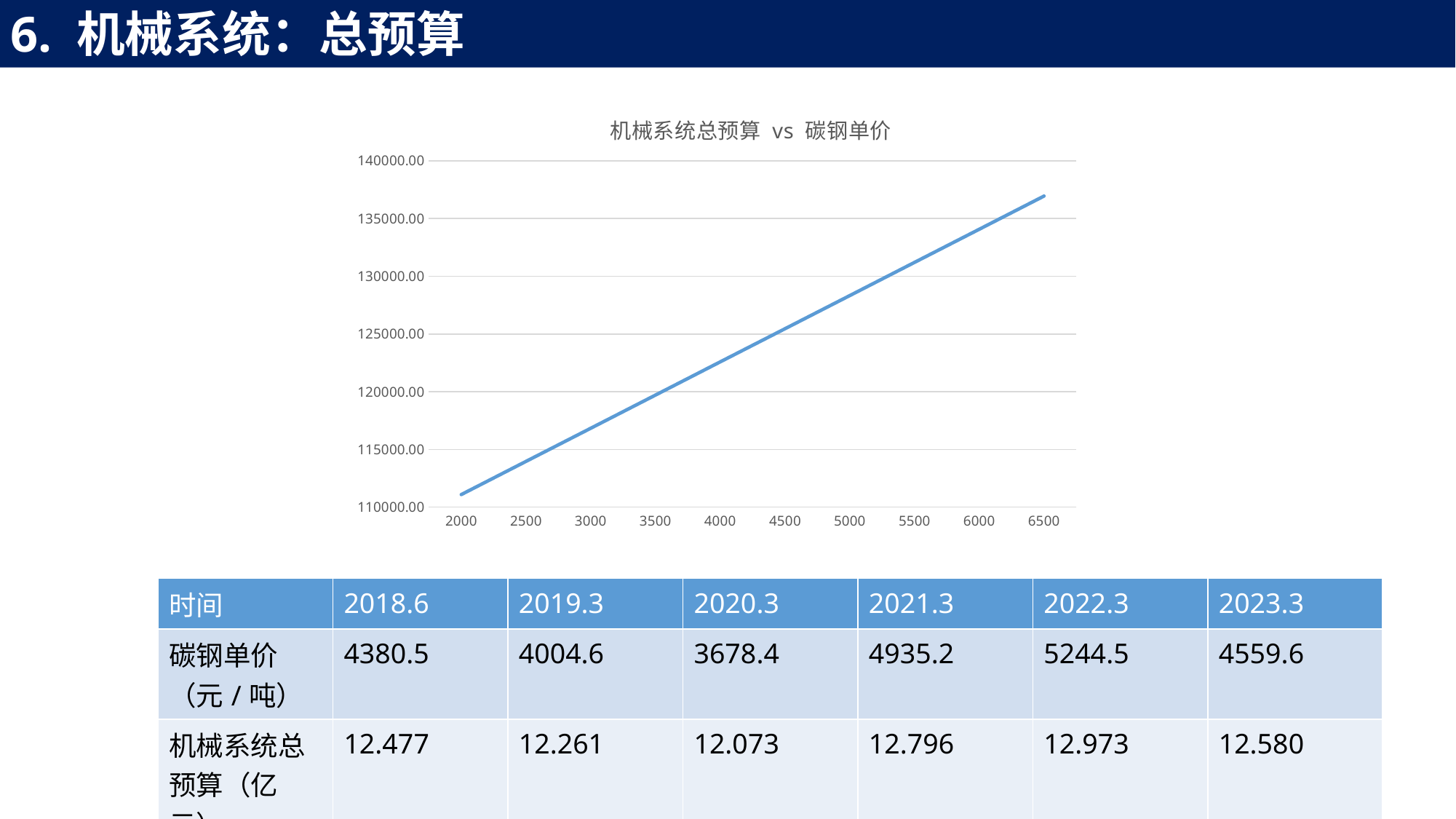
What kind of chart is shown on the slide? line chart How many tick labels are shown on the x axis of the chart? 10 Is the value of the line at x = 4000 greater or less than 120000? greater Which is larger, the value of the line at x = 6500 or at x = 2000? 6500 Does the line in the chart rise or fall as the x-axis value increases from 2000 to 6500? rise At which x-axis value does the line reach its lowest point? 2000 Is the value of the line at x = 5000 greater or less than 125000? greater At which x-axis value does the line reach its highest point? 6500 What is the lowest value labelled on the y axis of the chart? 110000.00 Is the value of the line at x = 6500 greater or less than 135000? greater What is the title of the chart? 机械系统总预算 vs 碳钢单价